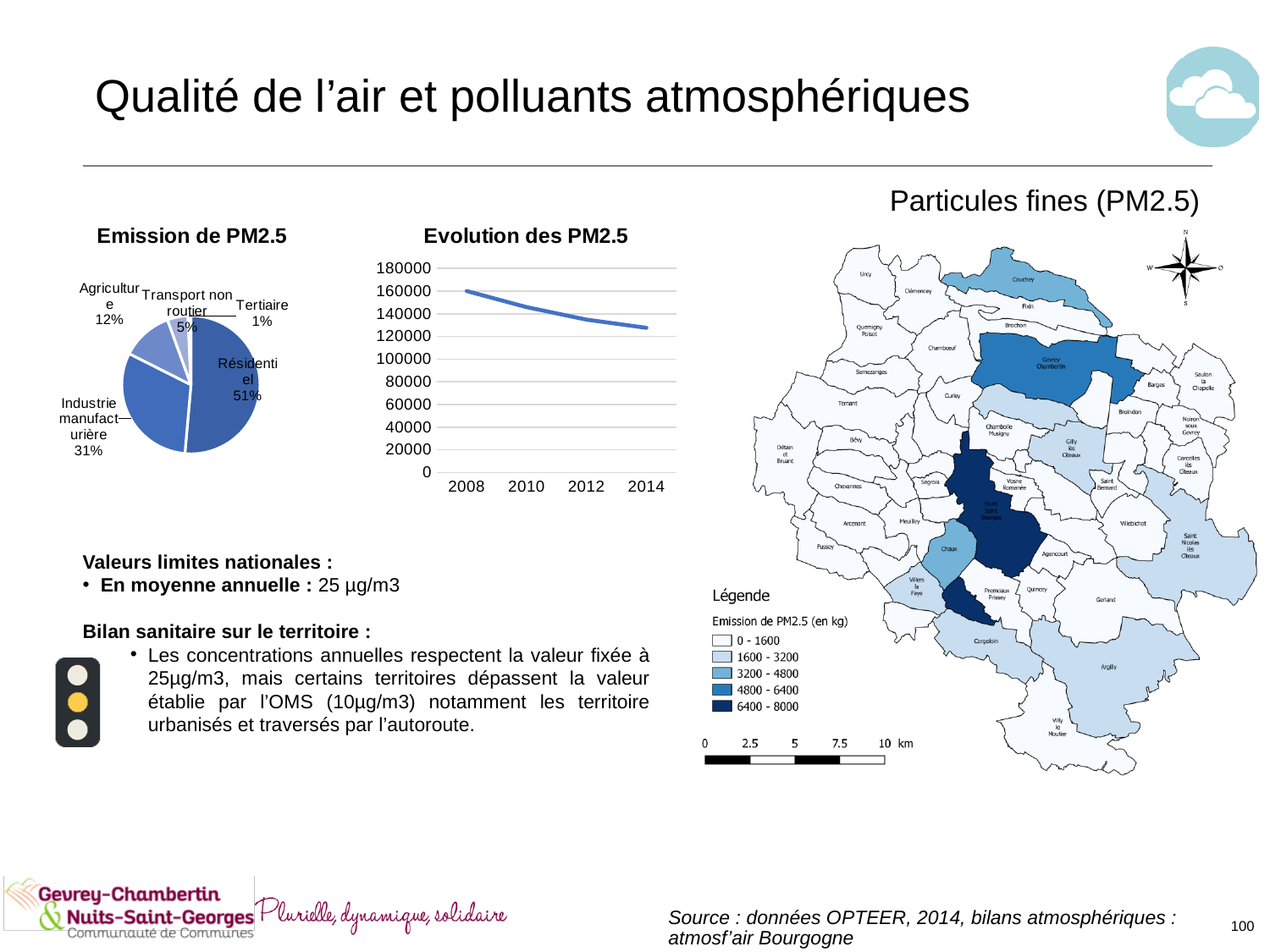
In the 'Emission de PM2.5' chart, what share does Résidentiel have? 51% What kind of chart is 'Emission de PM2.5'? Pie chart How many categories are shown in the 'Emission de PM2.5' chart? 5 In the 'Evolution des PM2.5' chart, is the value for 2014 greater or less than 140000? less In the 'Emission de PM2.5' chart, which is larger: Agriculture or Transport non routier? Agriculture In the 'Emission de PM2.5' chart, what share does Agriculture have? 12% In the 'Emission de PM2.5' chart, which category has the smallest share? Tertiaire In the 'Evolution des PM2.5' chart, do the values rise or fall from 2008 to 2014? Fall In the 'Emission de PM2.5' chart, what is the difference in percentage points between Résidentiel and Industrie manufacturière? 20 In the 'Emission de PM2.5' chart, which category has the largest share? Résidentiel In the 'Emission de PM2.5' chart, what share does Industrie manufacturière have? 31% In the 'Emission de PM2.5' chart, what share does Tertiaire have? 1%